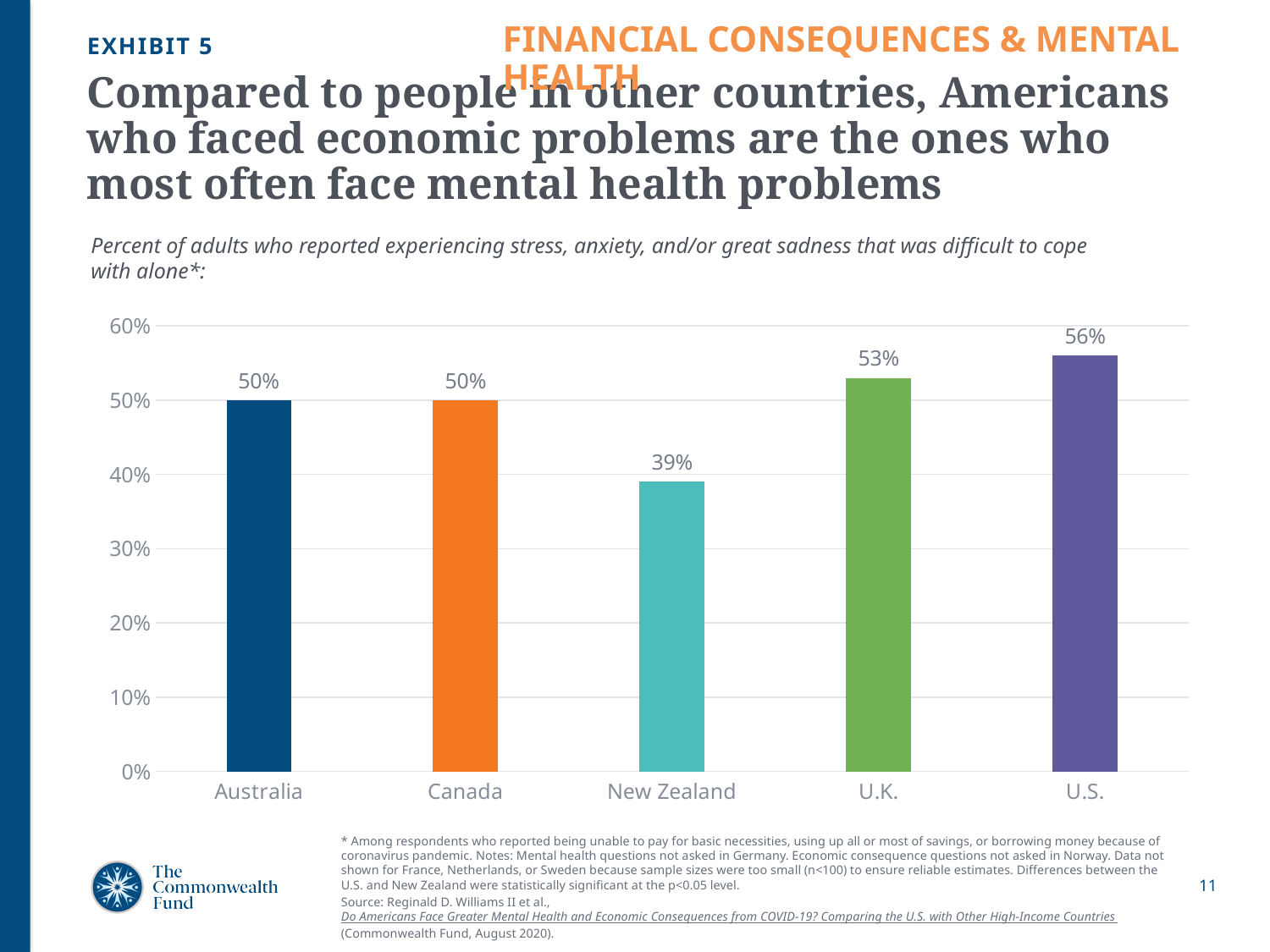
What percentage of adults in the U.S. reported experiencing stress, anxiety, and/or great sadness that was difficult to cope with alone? 56% What is the value shown for the U.K.? 53% What is the value shown for Canada? 50% Which country has the highest percentage in the chart? U.S. Which country has the lowest percentage in the chart? New Zealand How many countries are shown in the chart? 5 What kind of chart is shown on the slide? Bar chart What is the difference in percentage points between the U.S. and the U.K.? 3 Which is larger, the value for the U.K. or the value for Australia? U.K. What is the value shown for New Zealand? 39% What is the difference in percentage points between the U.S. and New Zealand? 17 What is the highest value labelled on the vertical axis? 60%